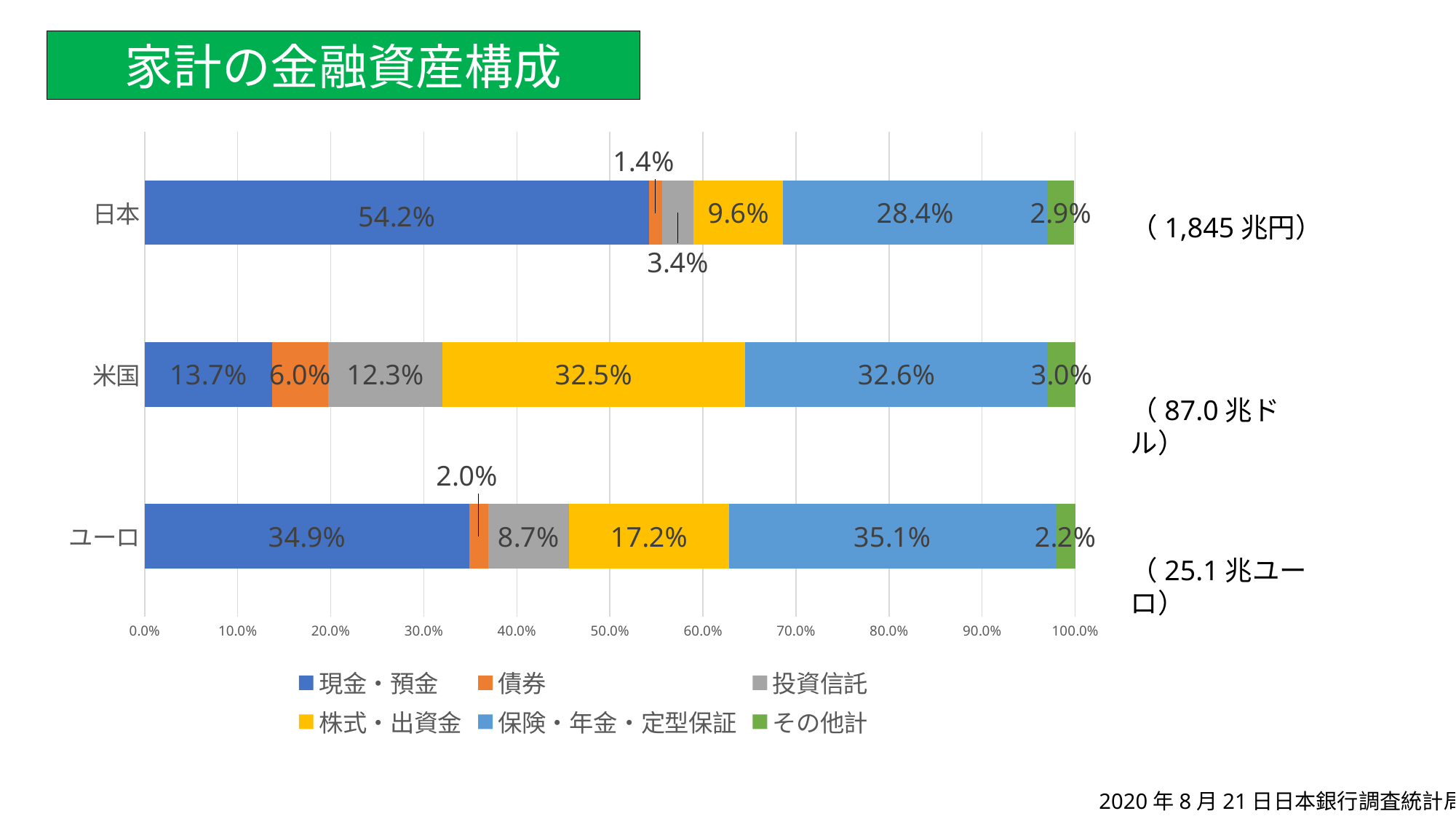
How many series does the legend list? 6 What is the value for 債券 in the 日本 bar? 1.4% What is the value for 株式・出資金 in the 米国 bar? 32.5% What is the difference between the 現金・預金 values for 日本 and 米国? 40.5% What kind of chart is shown on the slide? Stacked bar chart Which is larger: the 株式・出資金 value for 米国 or for ユーロ? 米国 What is the value for 現金・預金 in the 日本 bar? 54.2% Which category has the highest value for 現金・預金? 日本 What is the value for 保険・年金・定型保証 in the ユーロ bar? 35.1% How many categories are shown on the y axis? 3 Which category has the lowest value for その他計? ユーロ What is the value for 投資信託 in the ユーロ bar? 8.7%